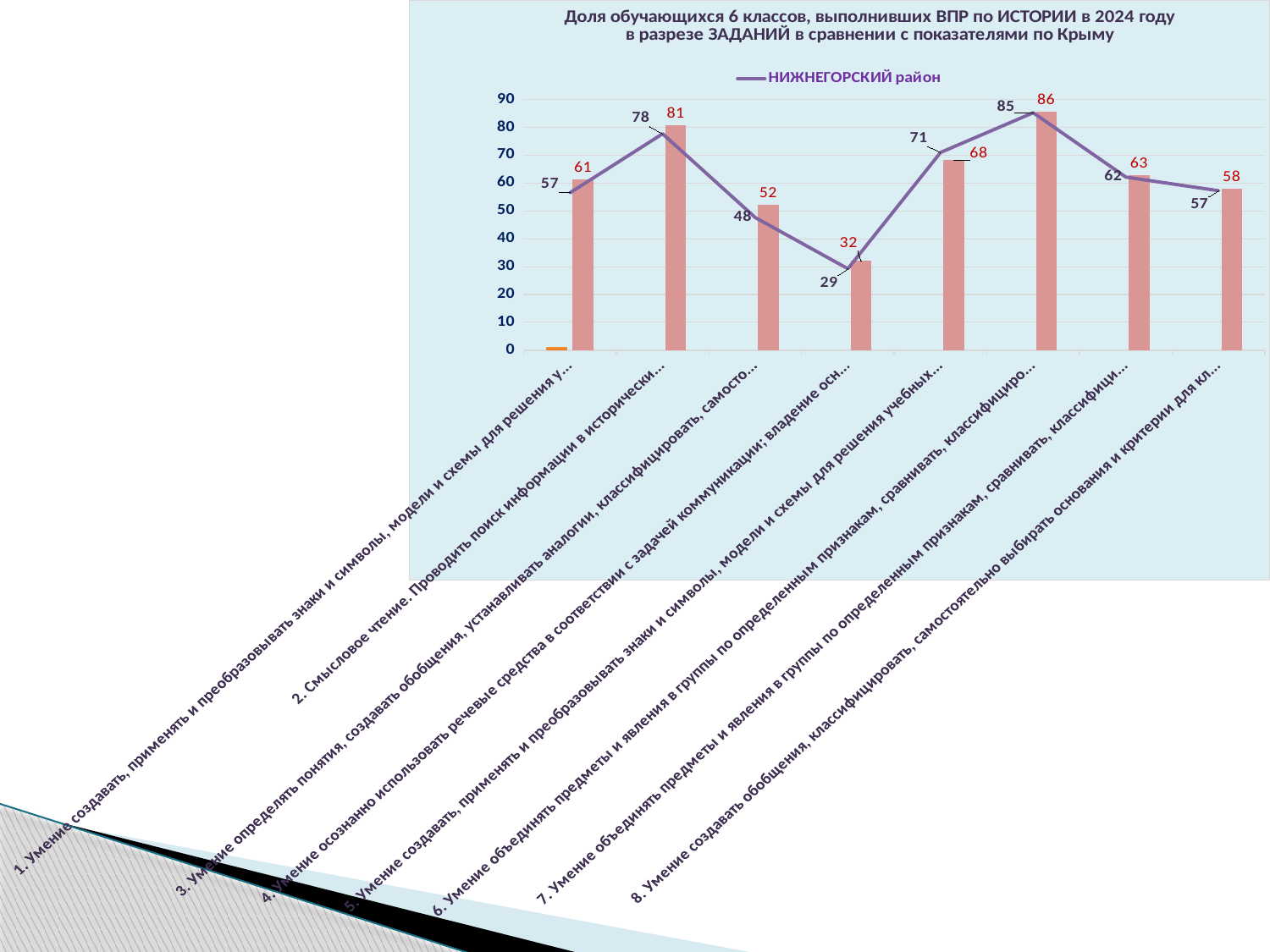
How many tasks (categories) are shown on the x axis? 8 What is the value of the НИЖНЕГОРСКИЙ район line for task 2 (Смысловое чтение)? 78 What kind of chart is this? A combined bar and line chart Does the НИЖНЕГОРСКИЙ район line rise or fall from task 2 to task 4? Fall For task 1, which is larger: the bar value or the НИЖНЕГОРСКИЙ район line value? The bar value (61) What is the value of the НИЖНЕГОРСКИЙ район line for task 8 (Умение создавать обобщения, классифицировать...)? 57 For task 6, what is the difference between the bar value and the НИЖНЕГОРСКИЙ район line value? 1 What is the bar value for task 6 (Умение объединять предметы и явления в группы...)? 86 Which task has the lowest bar value? Task 4 For which task does the НИЖНЕГОРСКИЙ район line reach its highest value? Task 6 What is the bar value for task 4 (Умение осознанно использовать речевые средства...)? 32 For task 3, what is the difference between the bar value and the НИЖНЕГОРСКИЙ район line value? 4